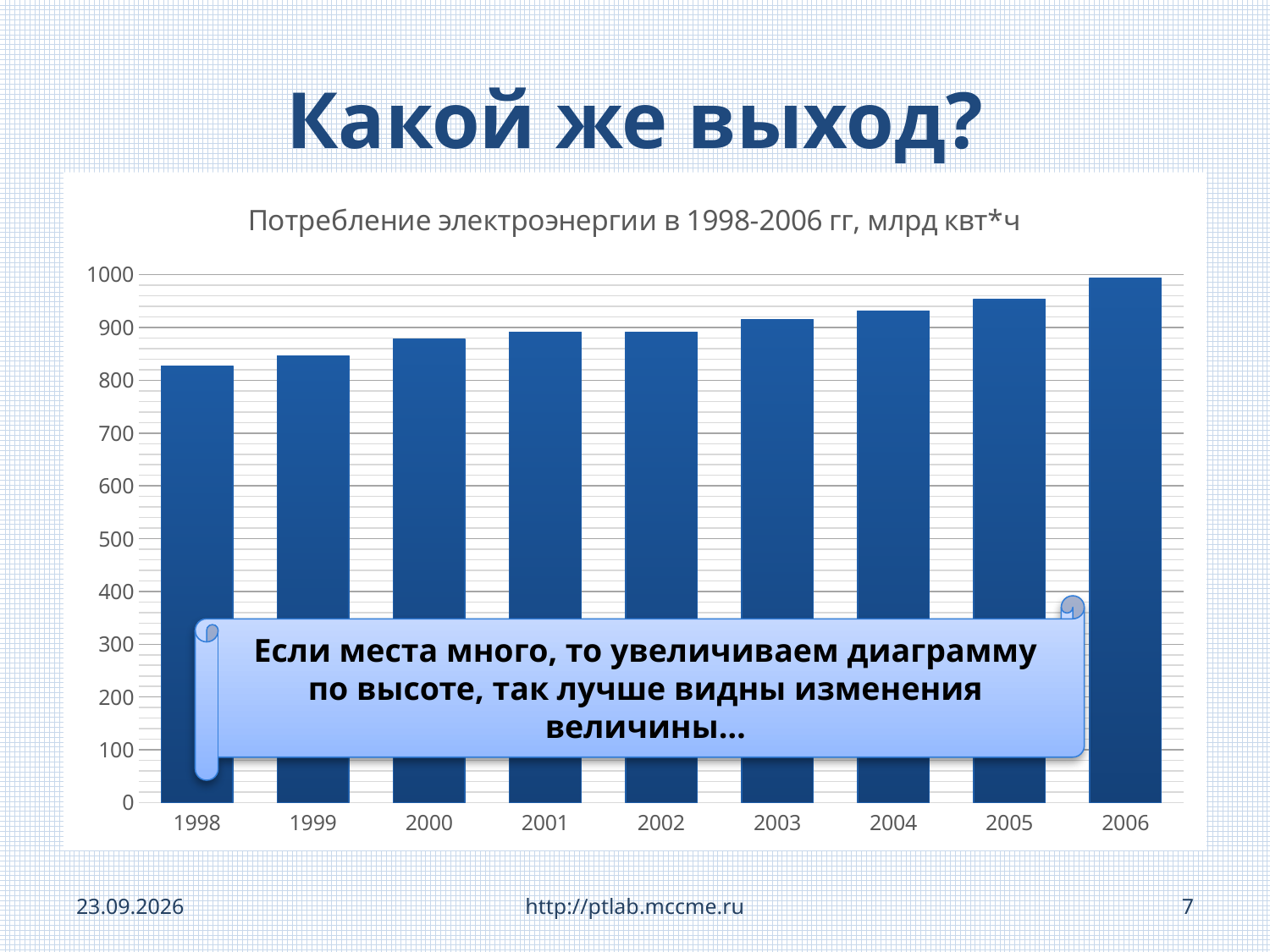
Is the value for 2006 greater or less than 900? greater Is the value for 1998 greater or less than 900? less Which year has the highest electricity consumption? 2006 Is the value for 1999 greater or less than 800? greater Which is larger, the value for 1998 or the value for 2004? 2004 What is the title of the chart? Потребление электроэнергии в 1998-2006 гг, млрд квт*ч What kind of chart is shown on the slide? bar chart How many years (categories) are plotted on the x axis? 9 Which is larger, the value for 2005 or the value for 2003? 2005 Do the values rise or fall from 1998 to 2006? rise Which year has the lowest electricity consumption? 1998